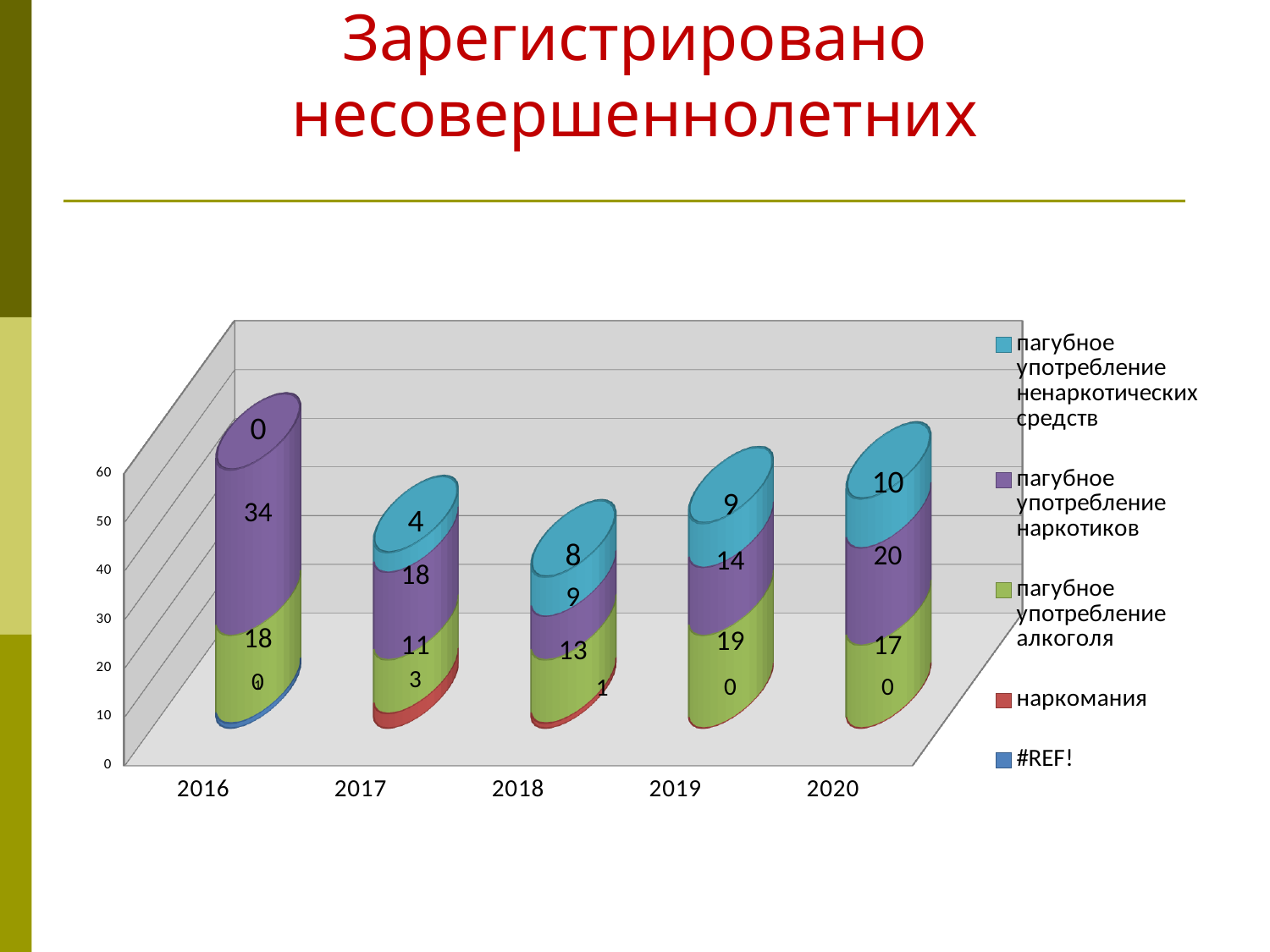
How many series does the legend list? 5 Which year has the larger value for пагубное употребление алкоголя, 2019 or 2020? 2019 What kind of chart is shown on the slide? Stacked bar chart In which year is the value for пагубное употребление ненаркотических средств the lowest? 2016 What is the value for пагубное употребление ненаркотических средств in 2020? 10 What is the value for наркомания in 2018? 1 Do the values for пагубное употребление ненаркотических средств rise or fall from 2017 to 2020? Rise How many years are shown on the x axis? 5 What is the value for пагубное употребление наркотиков in 2017? 18 What is the difference between the пагубное употребление наркотиков values for 2020 and 2018? 11 In which year is the value for пагубное употребление наркотиков the highest? 2016 What is the value for пагубное употребление алкоголя in 2019? 19